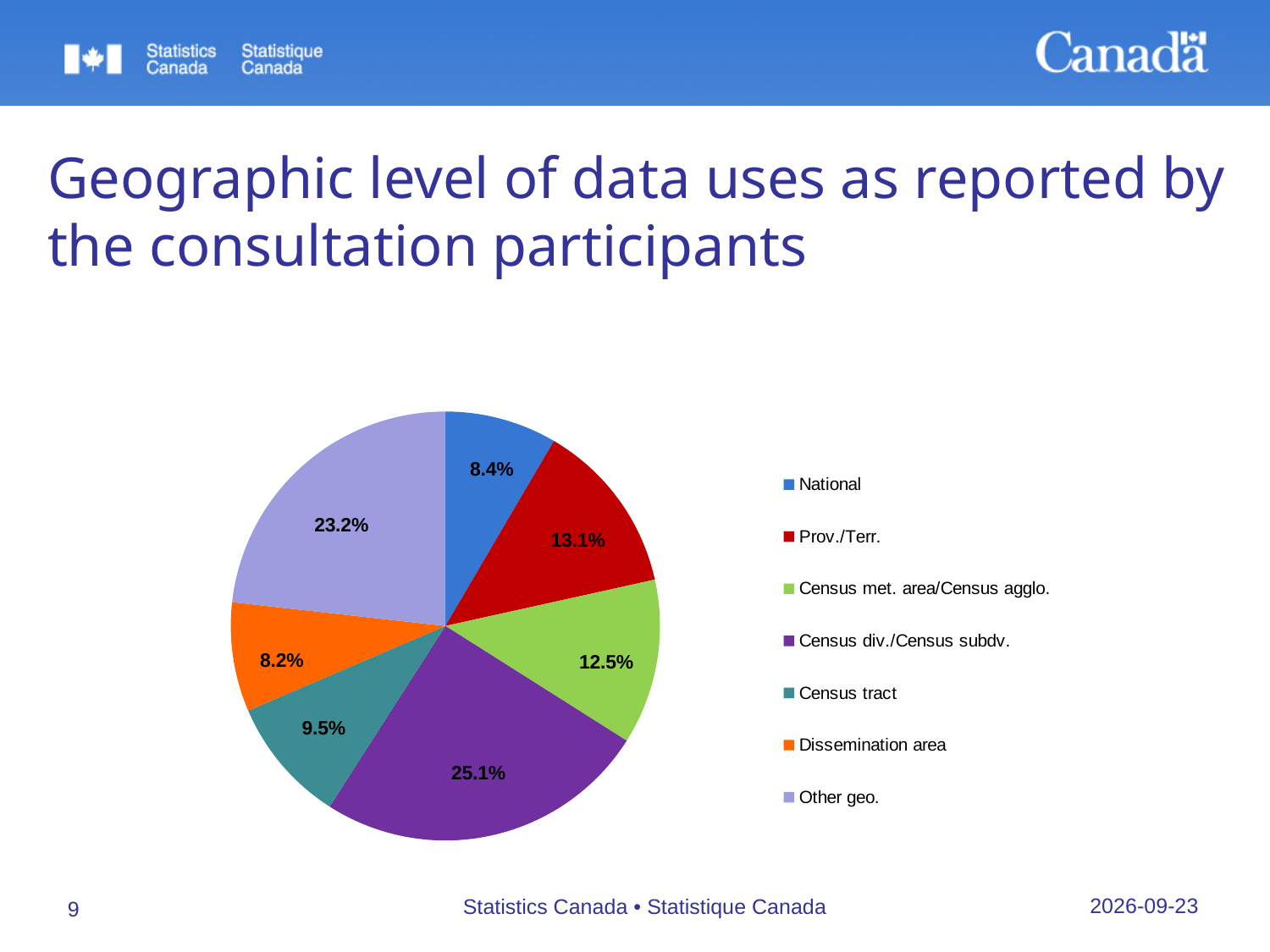
What kind of chart is shown on the slide? Pie chart What share of the pie does Census div./Census subdv. account for? 25.1% Which is larger, the share for Prov./Terr. or the share for Census met. area/Census agglo.? Prov./Terr. What percentage is shown for National? 8.4% What is the difference in percentage points between Census div./Census subdv. and Other geo.? 1.9 What value is labelled for Prov./Terr.? 13.1% How many categories are shown in the pie chart? 7 What is the combined share of Census tract and Dissemination area? 17.7% Which category has the largest slice of the pie? Census div./Census subdv. Which category has the smallest slice of the pie? Dissemination area What percentage is shown for Dissemination area? 8.2% Which legend entry is shown in orange? Dissemination area